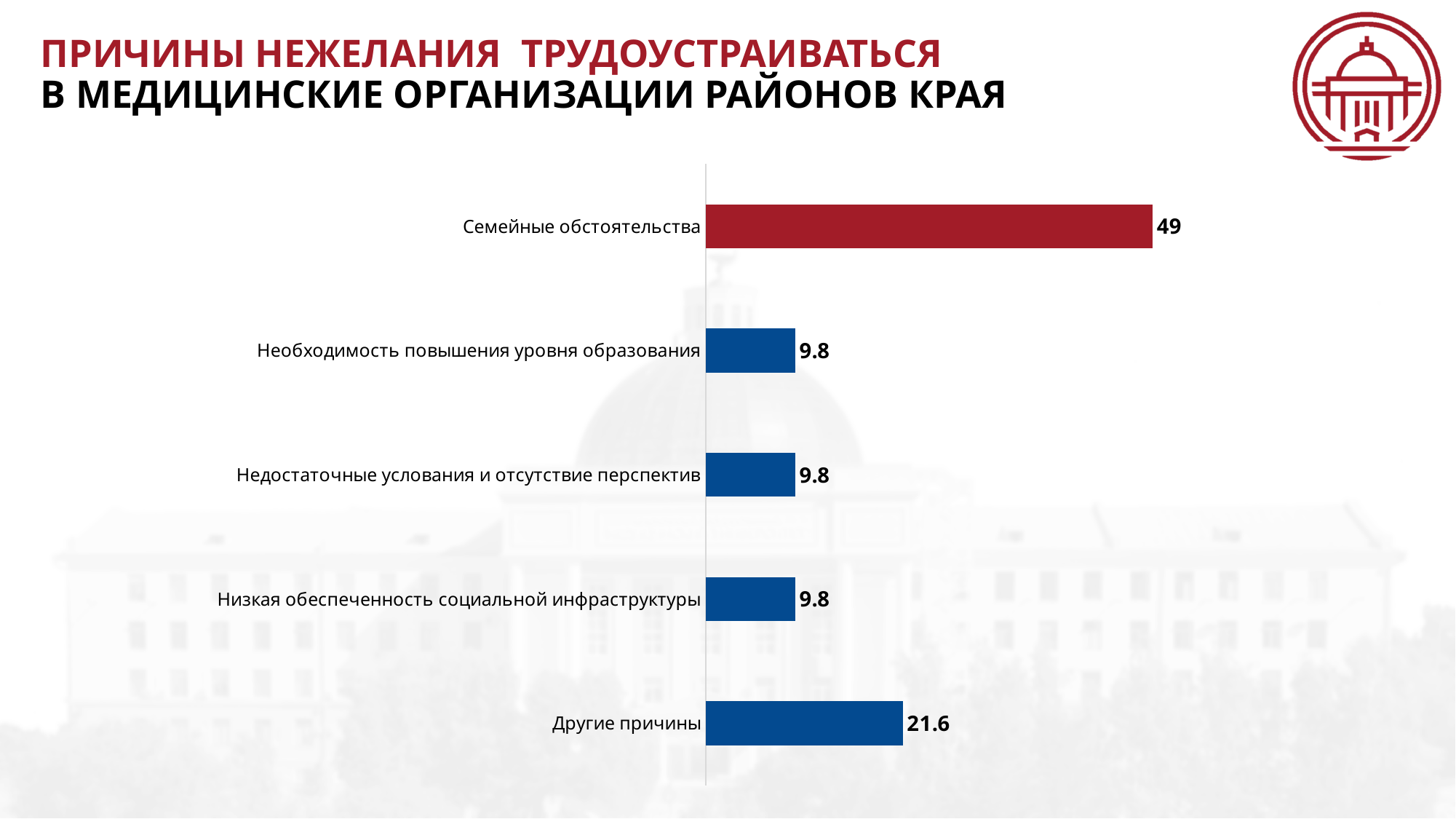
What is the value for Семейные обстоятельства? 49 What is the value for Низкая обеспеченность социальной инфраструктуры? 9.8 What is the value for Другие причины? 21.6 What is the difference between the values for Другие причины and Недостаточные условия и отсутствие перспектив? 11.8 Which category has the highest value? Семейные обстоятельства How many categories have a value of 9.8? 3 How many categories are shown in the chart? 5 What kind of chart is shown on the slide? bar chart What is the value for Необходимость повышения уровня образования? 9.8 Which is larger, the value for Другие причины or the value for Недостаточные условия и отсутствие перспектив? Другие причины What is the difference between the values for Семейные обстоятельства and Другие причины? 27.4 Which bar is coloured red rather than blue? Семейные обстоятельства